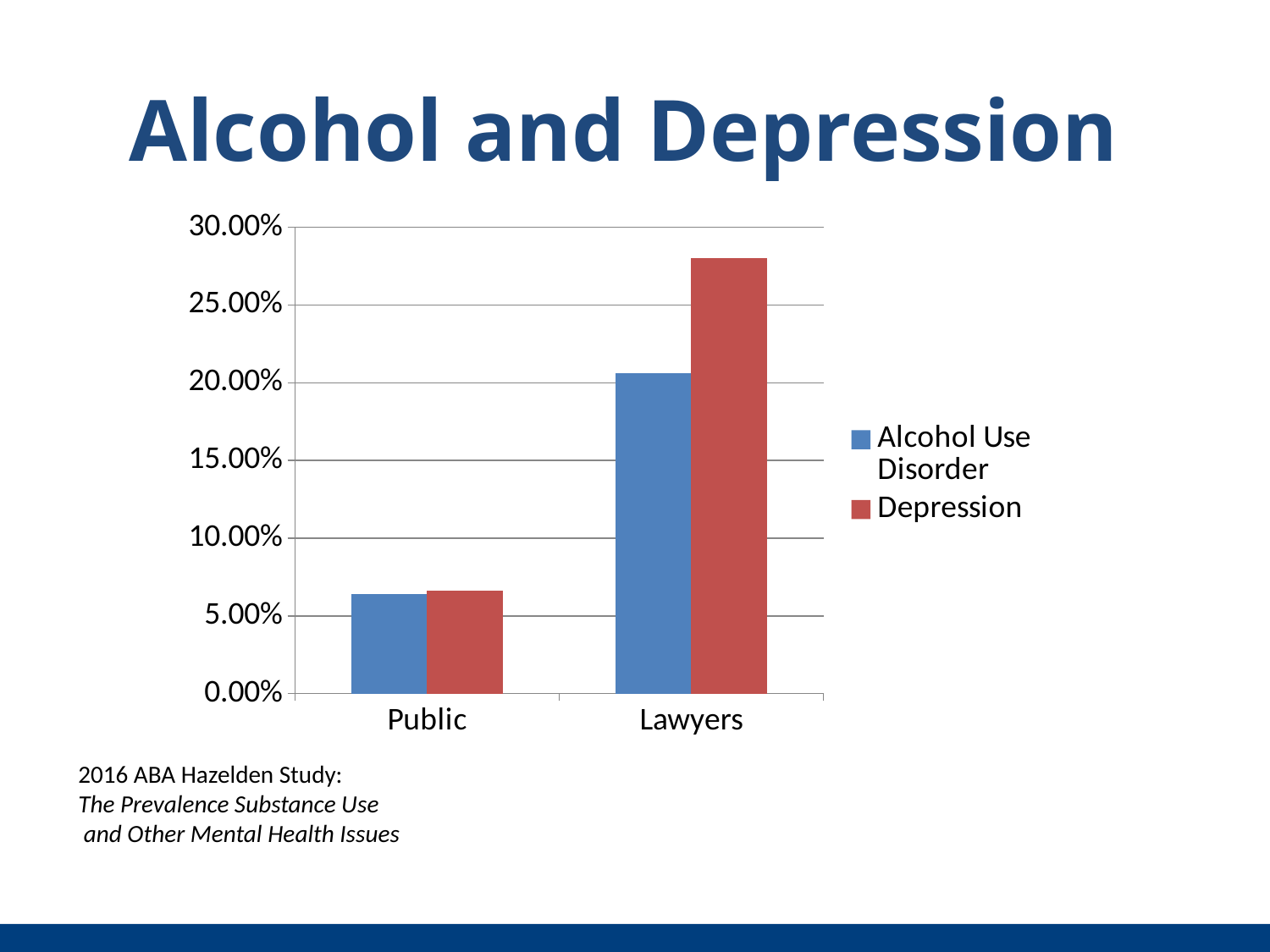
How many categories are shown on the x axis? 2 What colour represents the Depression series? red Is the Depression value for Lawyers greater or less than 25.00%? greater For Lawyers, which is larger: Alcohol Use Disorder or Depression? Depression Which category has the lowest Alcohol Use Disorder value? Public Which category has the highest Depression value? Lawyers Is the Depression value for Public greater or less than 5.00%? greater How many series does the legend list? 2 What kind of chart is shown on the slide? bar chart Do the Alcohol Use Disorder values rise or fall from Public to Lawyers? rise Is the Alcohol Use Disorder value for Public greater or less than 10.00%? less